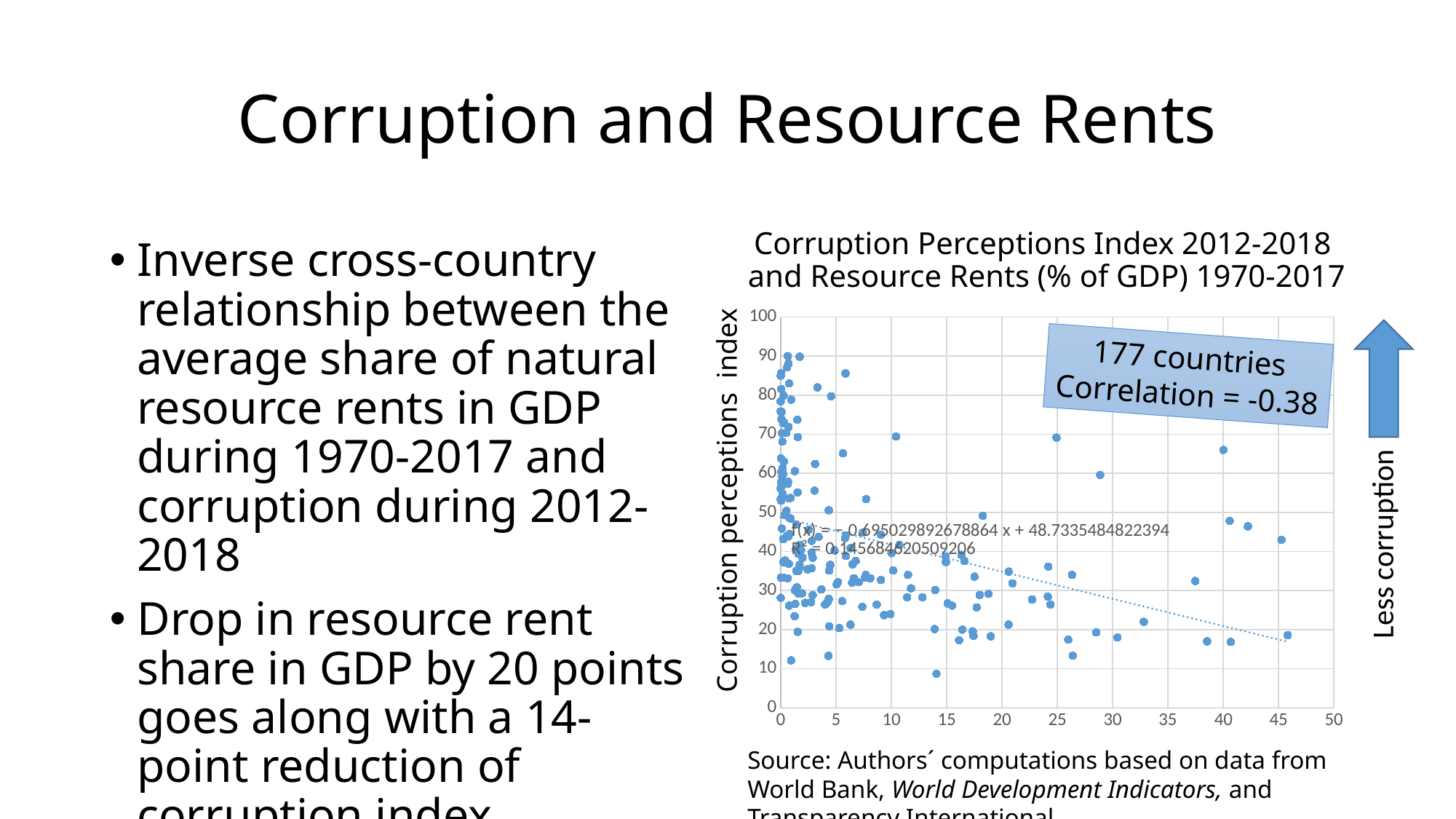
Is the highest corruption perceptions index value plotted on the chart greater or less than 80? greater What is the intercept of the fitted line equation shown on the chart? 48.7335484822394 According to the annotation on the chart, how many countries are plotted? 177 countries What is the title of the chart? Corruption Perceptions Index 2012-2018 and Resource Rents (% of GDP) 1970-2017 Is the lowest corruption perceptions index value plotted on the chart greater or less than 10? less What kind of chart is shown on the slide? Scatter chart What correlation value is stated on the chart? -0.38 What is the maximum value shown on the vertical axis of the chart? 100 What is the R² value shown on the chart? 0.145684620509206 What is the label of the vertical axis of the chart? Corruption perceptions index Does the fitted trend line on the chart rise or fall as resource rents increase along the x axis? Fall What is the maximum value shown on the horizontal axis of the chart? 50